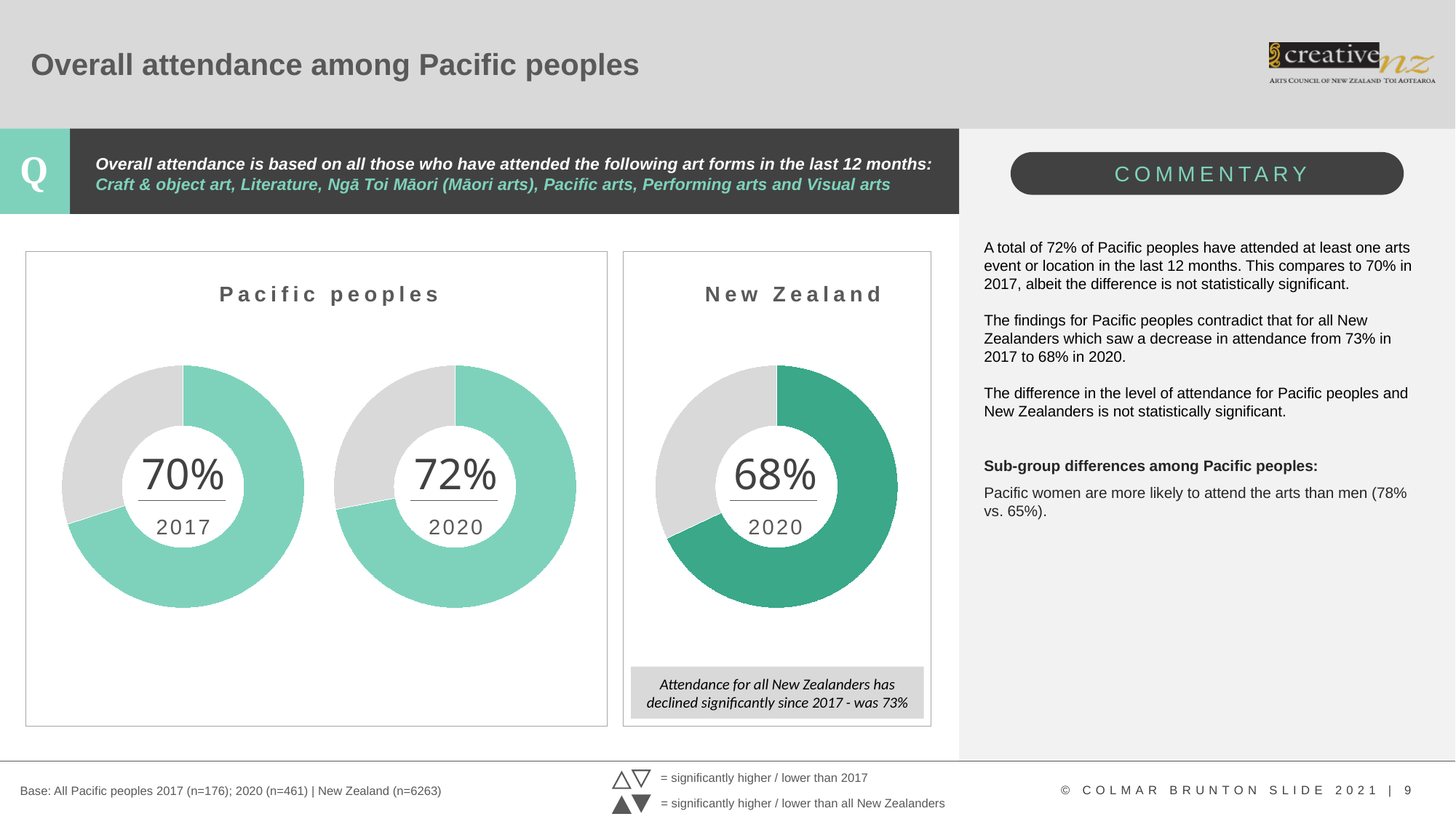
How many donut charts are shown in the Pacific peoples panel? 2 Which is larger: the Pacific peoples 2020 value or the New Zealand 2020 value? Pacific peoples 2020 In the Pacific peoples chart, what percentage is shown for 2017? 70% Which of the three donut charts shows the highest percentage? Pacific peoples 2020 In the New Zealand chart, what percentage is shown for 2020? 68% What is the difference between the Pacific peoples 2020 value and the New Zealand 2020 value? 4 percentage points In the Pacific peoples chart, by how many percentage points did attendance change from 2017 to 2020? 2 percentage points In the Pacific peoples chart, what percentage is shown for 2020? 72% Which of the three donut charts shows the lowest percentage? New Zealand 2020 What is the title of the chart panel on the right? New Zealand What type of chart is used to show the attendance figures on this slide? Donut chart In the Pacific peoples chart, did attendance rise or fall from 2017 to 2020? Rise